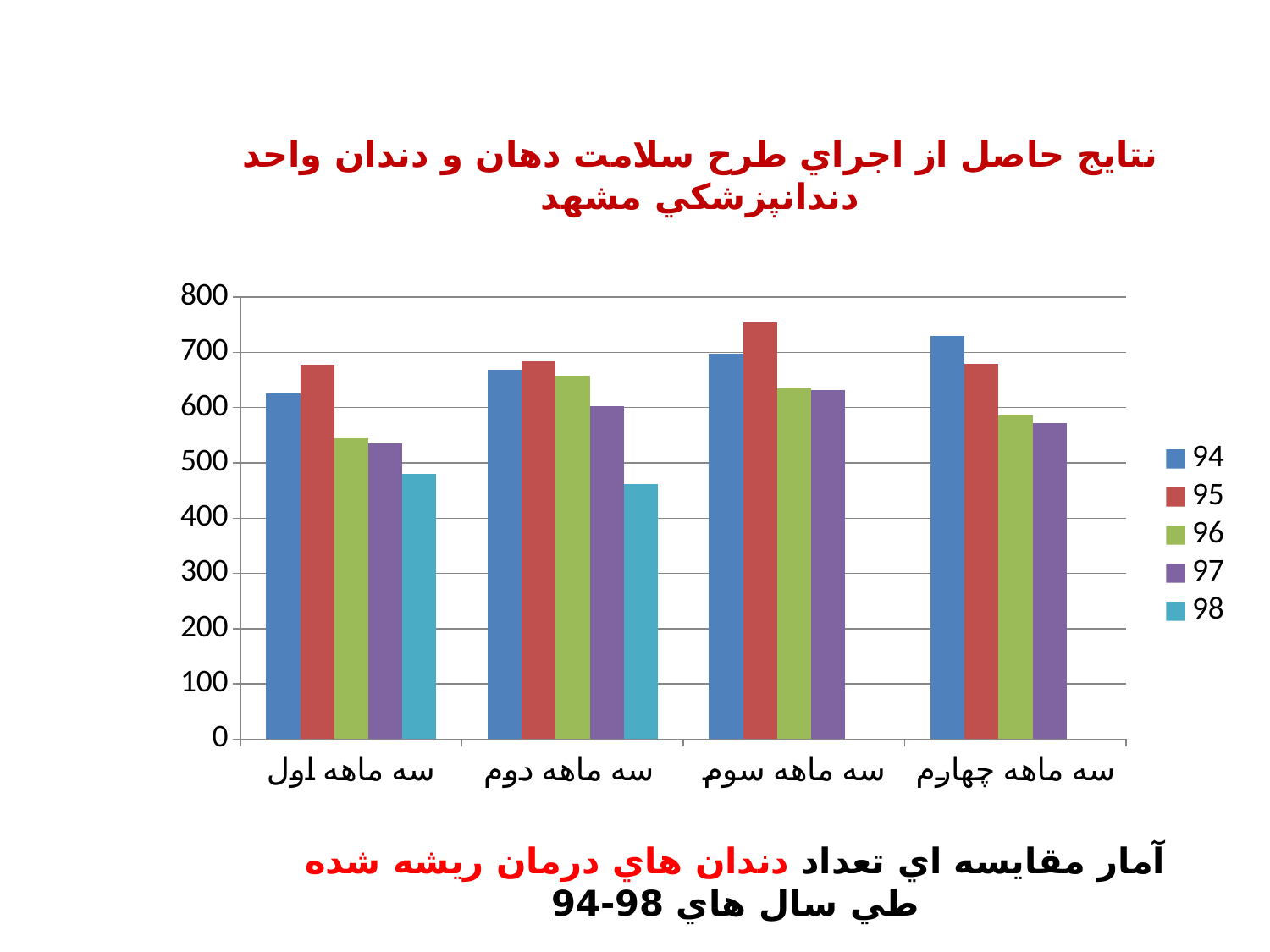
Is the value for series 97 in سه ماهه چهارم greater or less than 600? less Which series has the lowest value in سه ماهه دوم? 98 How many series does the legend list? 5 What kind of chart is shown on the slide? bar chart Which series has the highest value in سه ماهه سوم? 95 Is the value for series 95 in سه ماهه سوم greater or less than 700? greater Is the value for series 98 in سه ماهه اول greater or less than 500? less In سه ماهه اول, which is larger: the value for series 94 or series 95? 95 How many categories are shown on the x axis? 4 Which series has the highest value in سه ماهه چهارم? 94 Do the values for series 94 rise or fall from سه ماهه اول to سه ماهه چهارم? rise